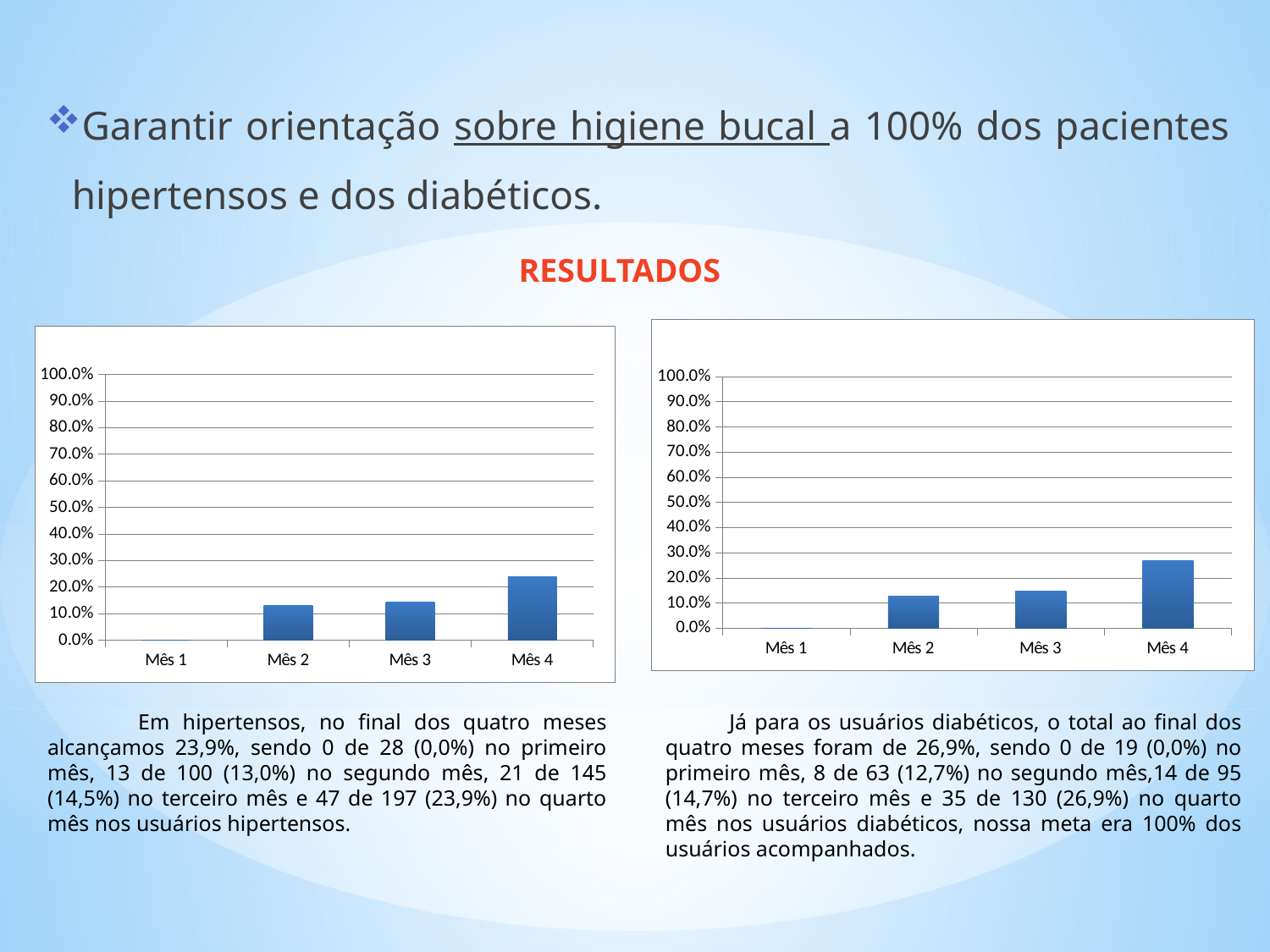
In the chart on the left of the slide, which month has the lowest value? Mês 1 In the chart on the right of the slide, is the value for Mês 4 greater or less than 20.0%? greater In the chart on the left of the slide, is the value for Mês 4 greater or less than 20.0%? greater In the chart on the left of the slide, how many months are shown on the x axis? 4 In the chart on the left of the slide, is the value for Mês 2 greater or less than 20.0%? less In the chart on the right of the slide, which month has the highest value? Mês 4 In the chart on the right of the slide, which is larger, the value for Mês 4 or the value for Mês 2? Mês 4 In the chart on the left of the slide, which month has the highest value? Mês 4 In the chart on the right of the slide, do the values rise or fall from Mês 1 to Mês 4? rise In the chart on the right of the slide, what is the highest value shown on the y axis? 100.0% In the chart on the left of the slide, what is the value for Mês 1? 0.0% What kind of chart is the chart on the left of the slide? Bar chart